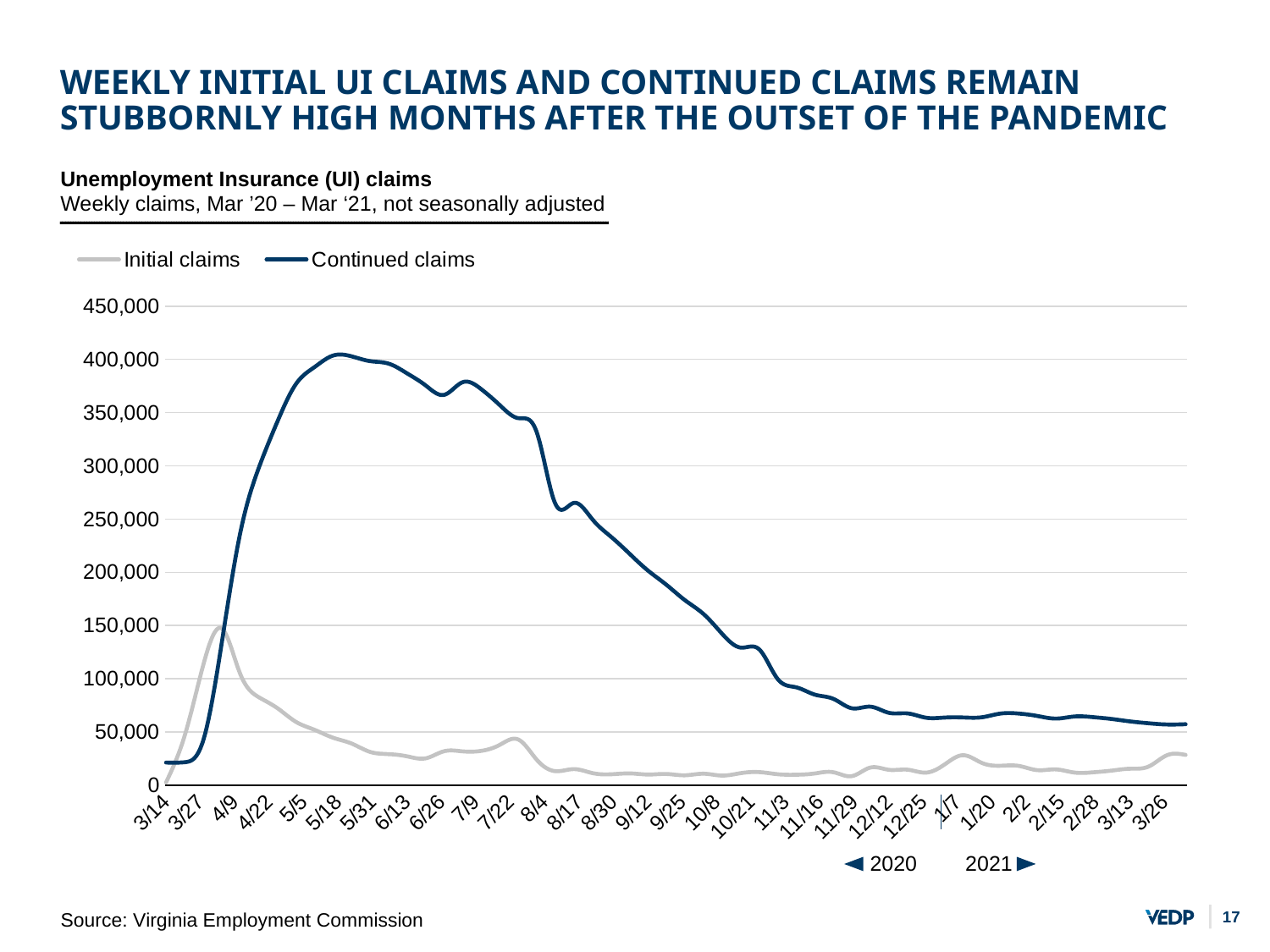
How many series does the legend list? 2 What colour is the line for Initial claims? Gray Is the value for Initial claims at 4/9 greater or less than 100,000? greater Is the value for Continued claims at 8/17 greater or less than 200,000? greater Which series reaches the highest value on the chart? Continued claims Do Continued claims rise or fall from 5/18 to 3/26? Fall What kind of chart is shown on the slide? Line chart At 7/9, which series has the higher value, Initial claims or Continued claims? Continued claims Is the value for Continued claims at 5/18 greater or less than 350,000? greater How many date labels are shown on the x axis? 30